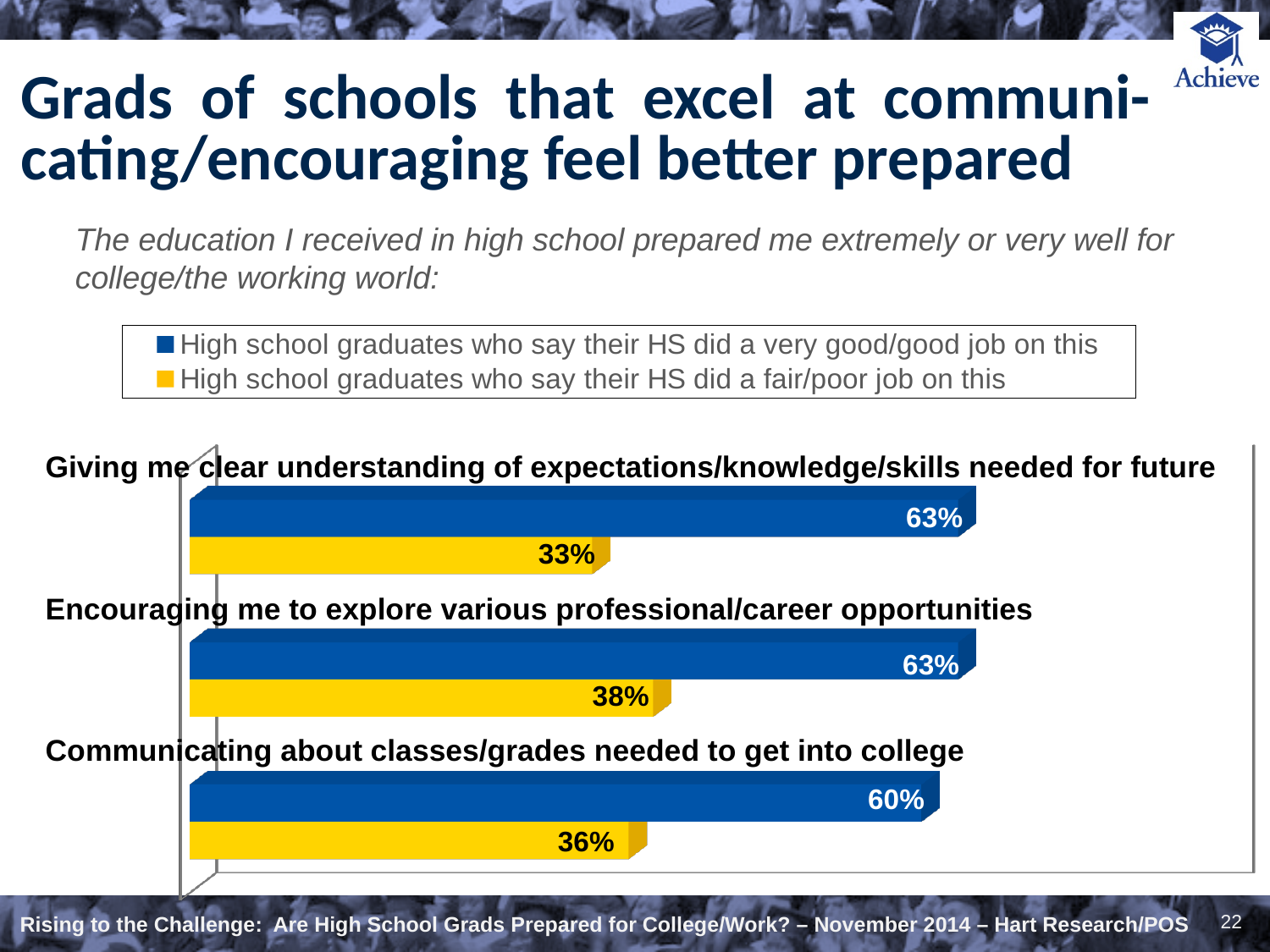
How many series does the legend list? 2 Among the fair/poor job bars, which category has the lowest value? Giving me clear understanding of expectations/knowledge/skills needed for future What is the difference between the very good/good and fair/poor values for 'Communicating about classes/grades needed to get into college'? 24 percentage points Which is larger: the fair/poor value for 'Encouraging me to explore various professional/career opportunities' or the fair/poor value for 'Communicating about classes/grades needed to get into college'? Encouraging me to explore various professional/career opportunities How many categories are shown in the chart? 3 What is the value for the very good/good job group on 'Communicating about classes/grades needed to get into college'? 60% What percentage of graduates who say their HS did a fair/poor job on 'Giving me clear understanding of expectations/knowledge/skills needed for future' feel extremely or very well prepared? 33% What is the difference between the very good/good and fair/poor values for 'Giving me clear understanding of expectations/knowledge/skills needed for future'? 30 percentage points Among the fair/poor job bars, which category has the highest value? Encouraging me to explore various professional/career opportunities What percentage of graduates who say their HS did a very good/good job on 'Giving me clear understanding of expectations/knowledge/skills needed for future' feel extremely or very well prepared? 63% What is the value for the fair/poor job group on 'Communicating about classes/grades needed to get into college'? 36% What is the value for the fair/poor job group on 'Encouraging me to explore various professional/career opportunities'? 38%